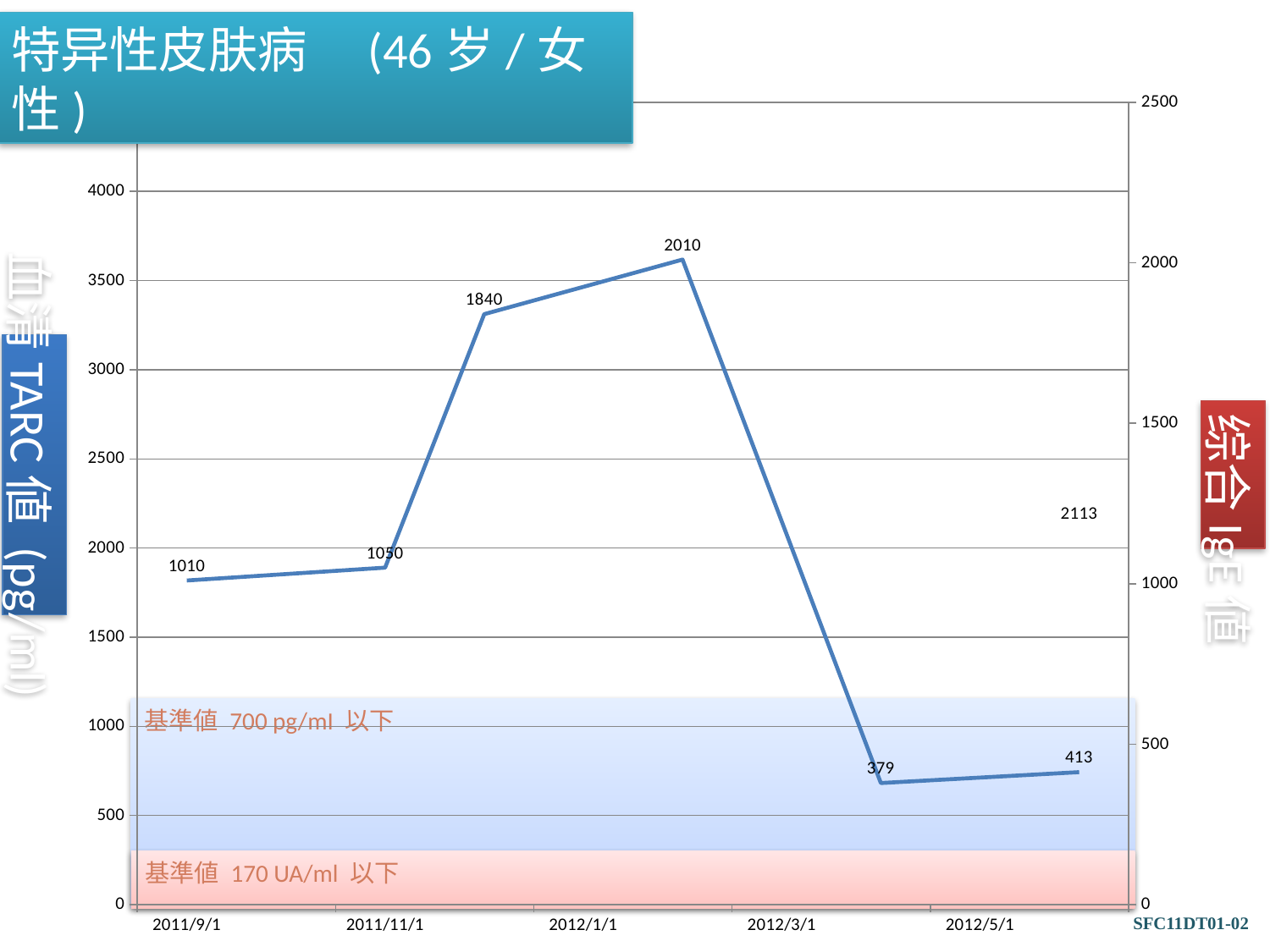
What is the value of the first data point, at 2011/9/1? 1010 What kind of chart is shown on the slide? line chart Is the value labelled 379 greater or less than 500 on the right-hand axis? less Does the line rise or fall between 2011/9/1 and 2011/11/1? rise What is the value of the data point at 2011/11/1? 1050 How many data points are labelled along the plotted line? 6 What is the title shown in the box at the top of the slide? 特异性皮肤病 (46 岁 / 女性) What is the difference between the peak value 2010 and the preceding value 1840? 170 Which is larger, the value labelled 1840 or the value labelled 1050? 1840 What is the highest labelled value on the line? 2010 What is the lowest labelled value on the line? 379 What is the difference between the last two labelled values, 413 and 379? 34